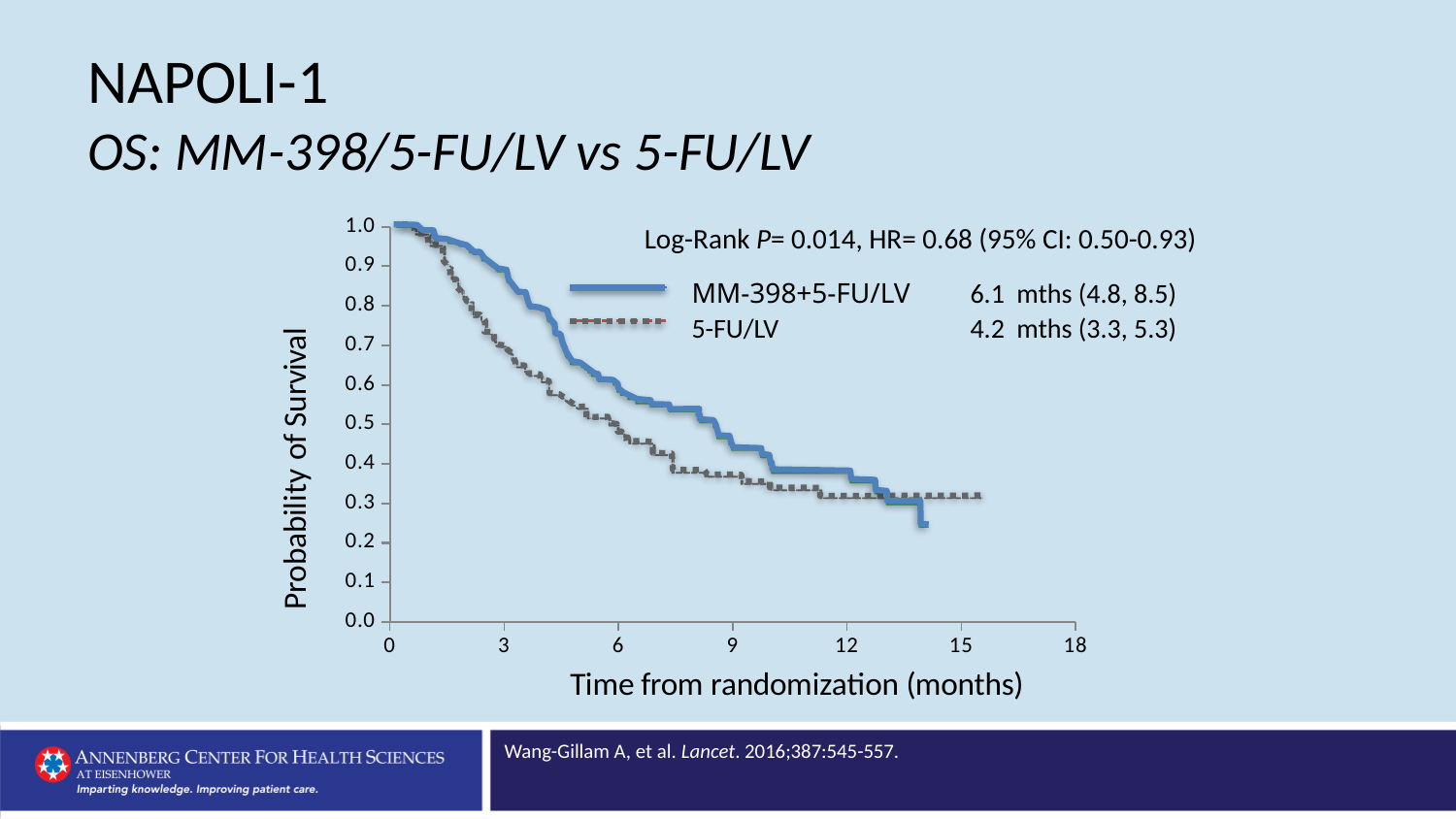
What is the label of the x axis? Time from randomization (months) Is the probability of survival for the 5-FU/LV arm at 3 months greater or less than 0.8? less What is the 95% confidence interval shown for the median survival of the 5-FU/LV arm? (3.3, 5.3) How many treatment arms are plotted on the chart? 2 Do the survival curves rise or fall as time from randomization increases? Fall Which arm has the longer median overall survival? MM-398+5-FU/LV What kind of chart is shown on the slide? Line chart (Kaplan-Meier survival curve) What is the log-rank P value shown on the chart? 0.014 What is the median overall survival shown for the 5-FU/LV arm? 4.2 mths What is the median overall survival shown for the MM-398+5-FU/LV arm? 6.1 mths What is the difference in median overall survival between the MM-398+5-FU/LV arm and the 5-FU/LV arm? 1.9 mths What hazard ratio is reported on the chart? 0.68